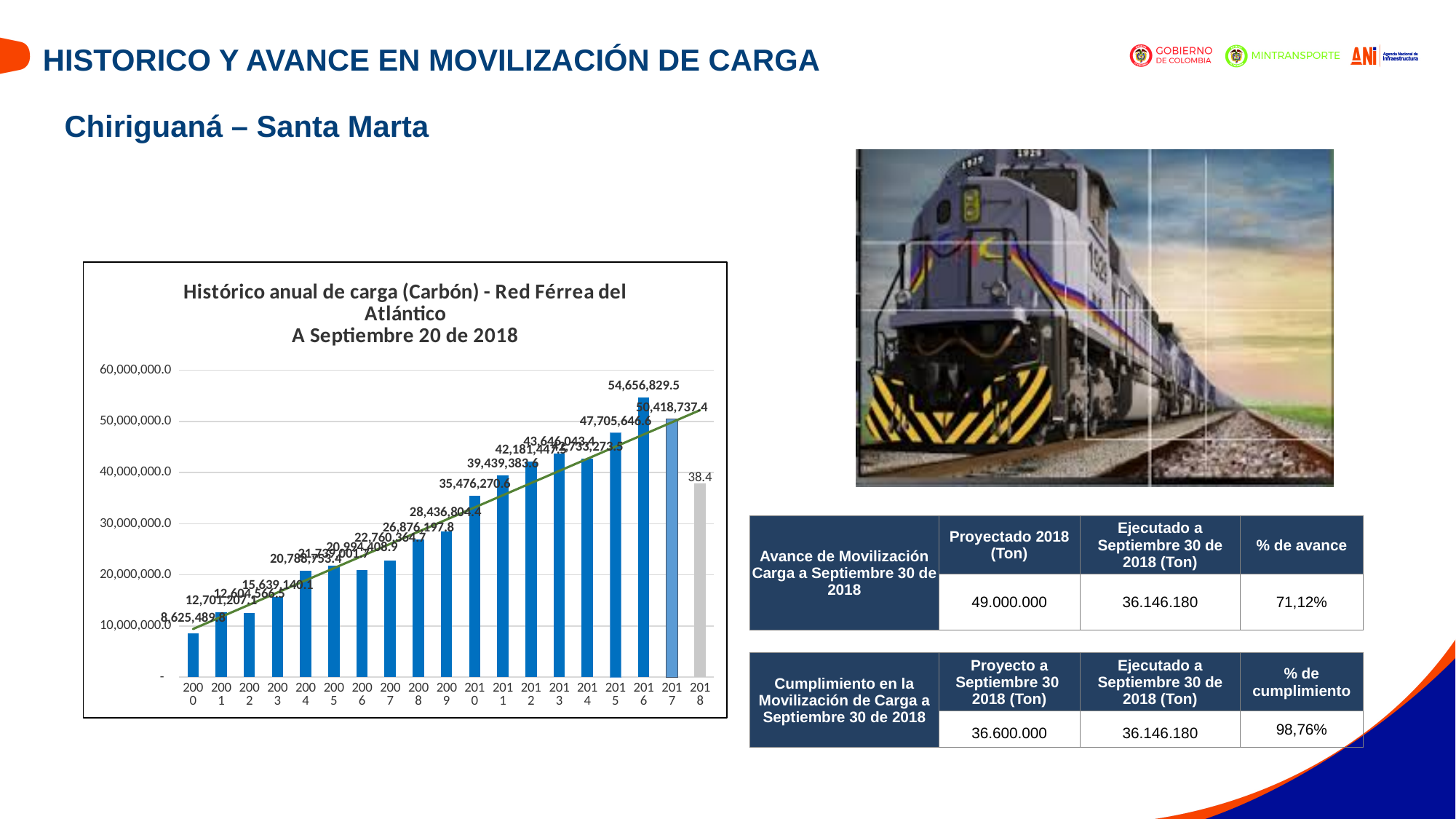
What is the value for 2000 in the chart? 8,625,489.8 What type of chart is shown on the slide? Bar chart Which year has the lowest value in the chart? 2000 What is the value for 2010 in the chart? 35,476,270.6 What is the difference between the values for 2016 and 2017? 4,238,092.1 What is the value for 2017 in the chart? 50,418,737.4 Which year has the highest value in the chart? 2016 How many years are shown on the x axis of the chart? 19 Which year has the larger value, 2015 or 2014? 2015 Is the value for 2018 greater or less than 40,000,000.0? less What is the value for 2016 in the chart? 54,656,829.5 What is the title of the chart? Histórico anual de carga (Carbón) - Red Férrea del Atlántico A Septiembre 20 de 2018